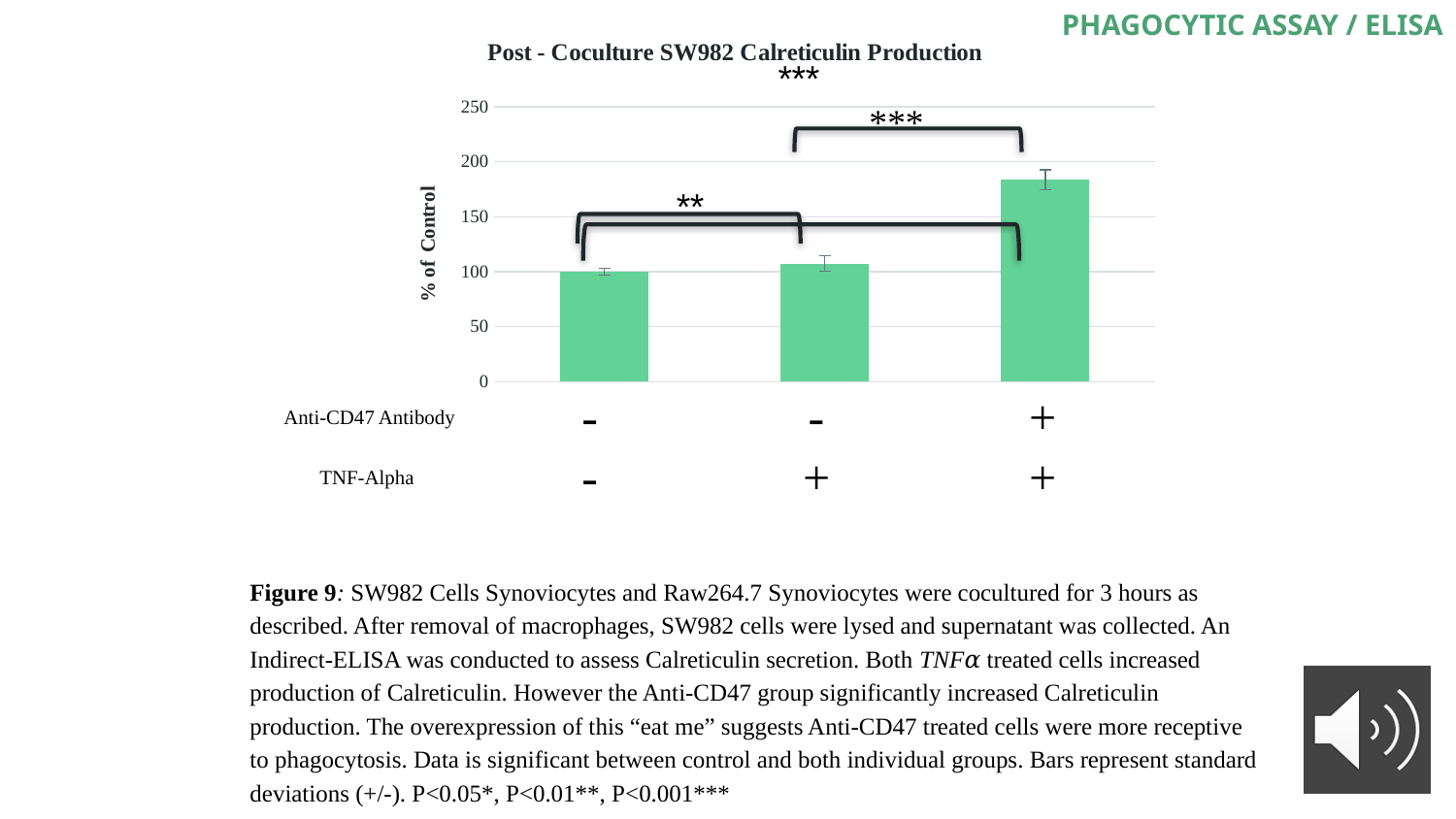
How many bars are plotted in the chart? 3 Is the value for the Anti-CD47 Antibody + / TNF-Alpha + condition greater or less than 200? less Is the value for the Anti-CD47 Antibody - / TNF-Alpha + condition greater or less than 150? less Do the bar values rise or fall from left to right across the chart? rise Is the value for the Anti-CD47 Antibody + / TNF-Alpha + condition greater or less than 150? greater Which condition has the highest % of Control? Anti-CD47 Antibody + / TNF-Alpha + What is the label on the y axis of the chart? % of Control Which condition has the lowest % of Control? Anti-CD47 Antibody - / TNF-Alpha - Which is larger: the value for Anti-CD47 Antibody + / TNF-Alpha + or the value for Anti-CD47 Antibody - / TNF-Alpha +? Anti-CD47 Antibody + / TNF-Alpha + What is the highest value shown on the y axis of the chart? 250 What is the title of the chart? Post - Coculture SW982 Calreticulin Production What type of chart is shown on the slide? bar chart